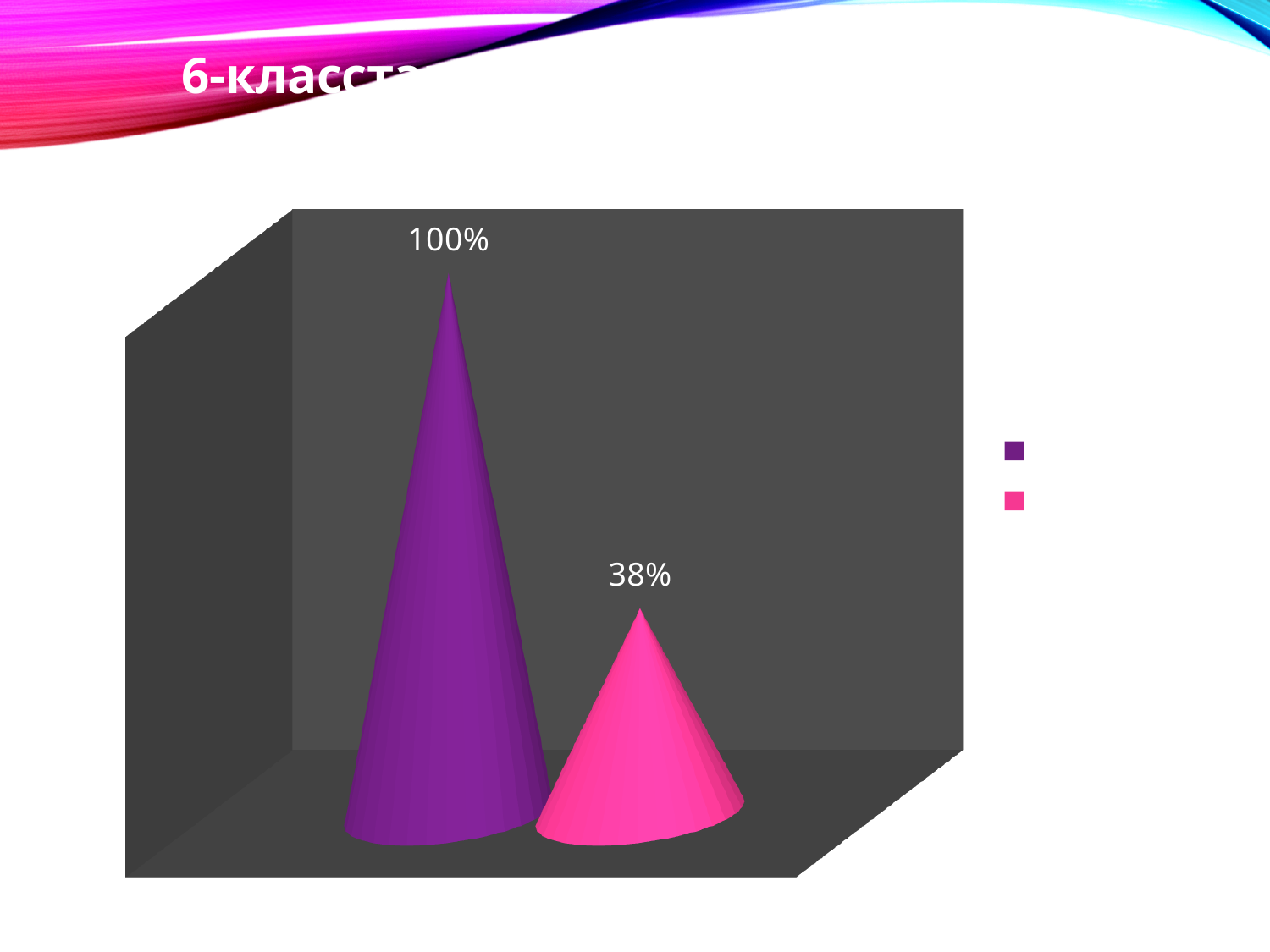
What colour is the cone labelled 100%? purple What is the difference between the values of the purple cone and the pink cone? 62% What value is shown on the purple cone? 100% What value is shown on the pink cone? 38% Is the value of the left cone larger or smaller than the value of the right cone? larger What colour is the cone labelled 38%? pink Which cone has the lowest value, the purple one or the pink one? the pink one How many cones (data points) are plotted in the chart? 2 Which cone has the highest value, the purple one or the pink one? the purple one How many entries does the legend list? 2 Do the values rise or fall from left to right across the chart? fall What kind of chart is shown on the slide? bar chart